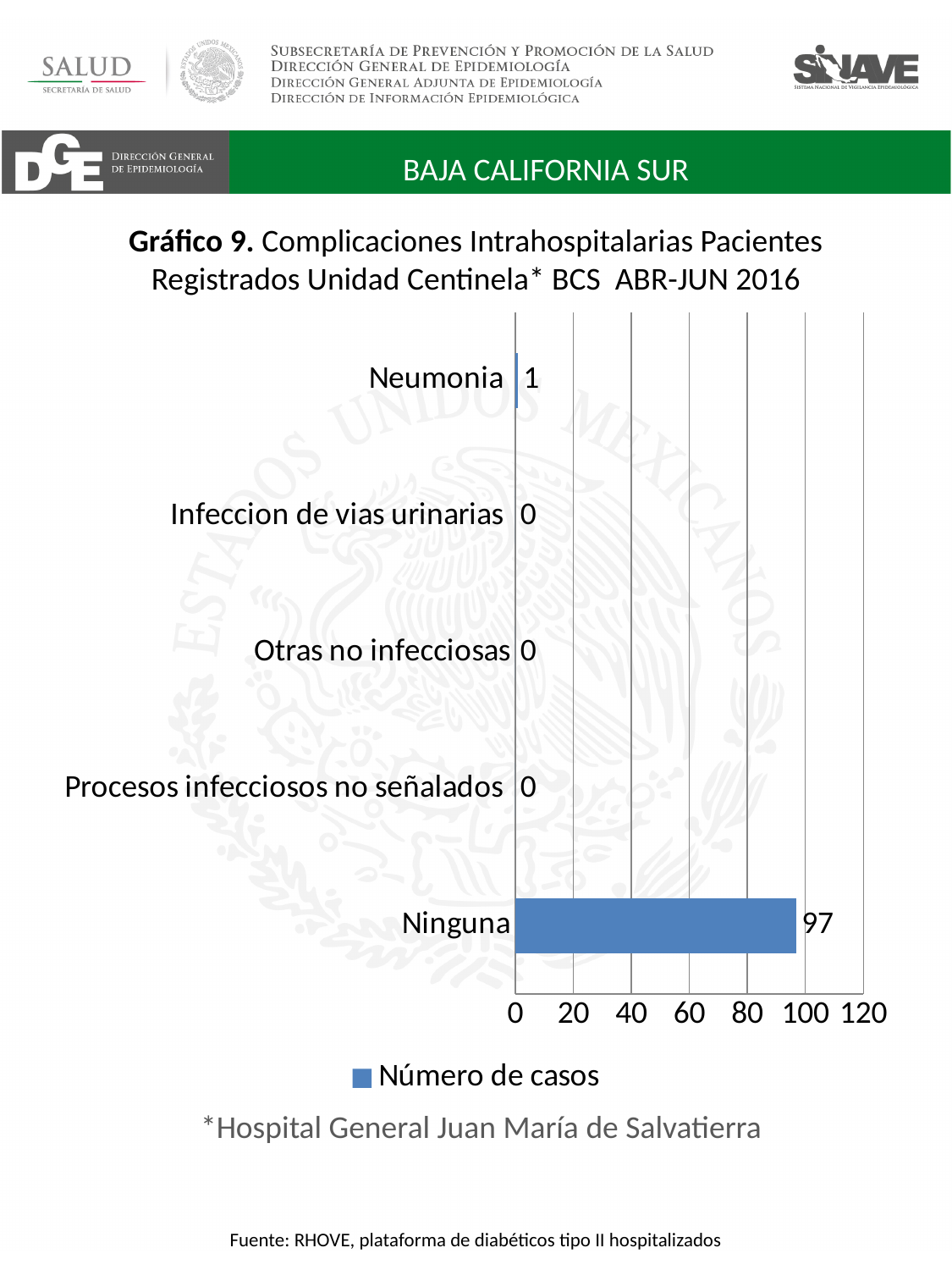
What is the difference between the values for Ninguna and Neumonia? 96 How many categories are shown on the chart? 5 What kind of chart is shown? bar chart What is the legend entry for the series? Número de casos Is the value for Ninguna greater or less than 80? greater How many series does the legend list? 1 What is the value for Infeccion de vias urinarias? 0 Which is larger, the value for Ninguna or the value for Neumonia? Ninguna Which category has the highest value? Ninguna What is the value for Procesos infecciosos no señalados? 0 What is the value for Neumonia? 1 What is the value for Ninguna? 97